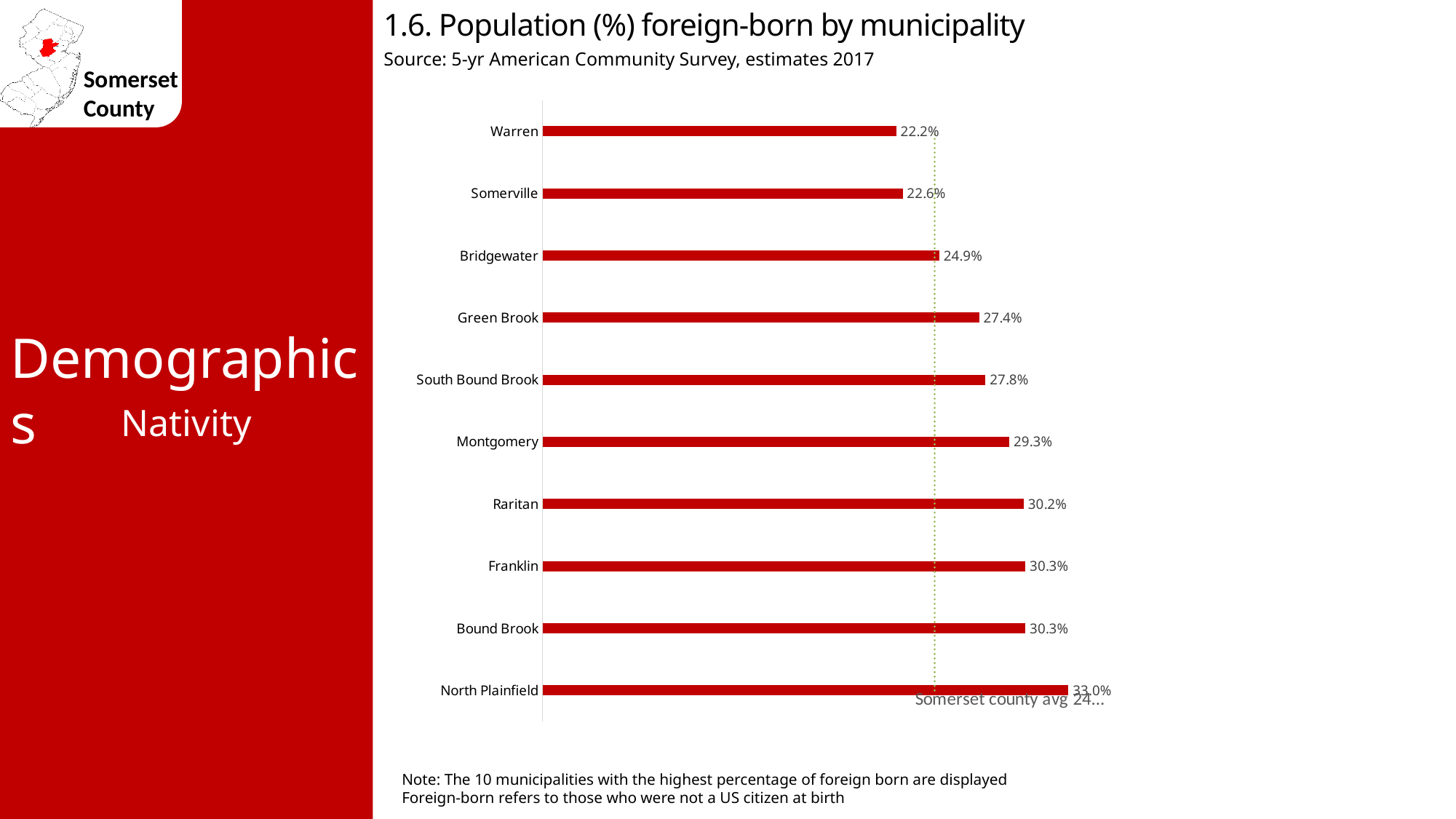
What is the difference in percentage points between North Plainfield and Warren? 10.8 What is the foreign-born population percentage for Montgomery? 29.3% Which municipality has the highest percentage of foreign-born population? North Plainfield What is the difference in percentage points between Raritan and Somerville? 7.6 What is the foreign-born population percentage for South Bound Brook? 27.8% Which has a higher foreign-born percentage, Green Brook or Bridgewater? Green Brook What does the vertical dotted line on the chart represent? Somerset county average Do the values increase or decrease going from the top bar (Warren) to the bottom bar (North Plainfield)? Increase What type of chart is used on this slide? Bar chart What is the foreign-born population percentage for Bridgewater? 24.9% How many municipalities are shown on the chart? 10 Which municipality has the lowest percentage of foreign-born population on the chart? Warren